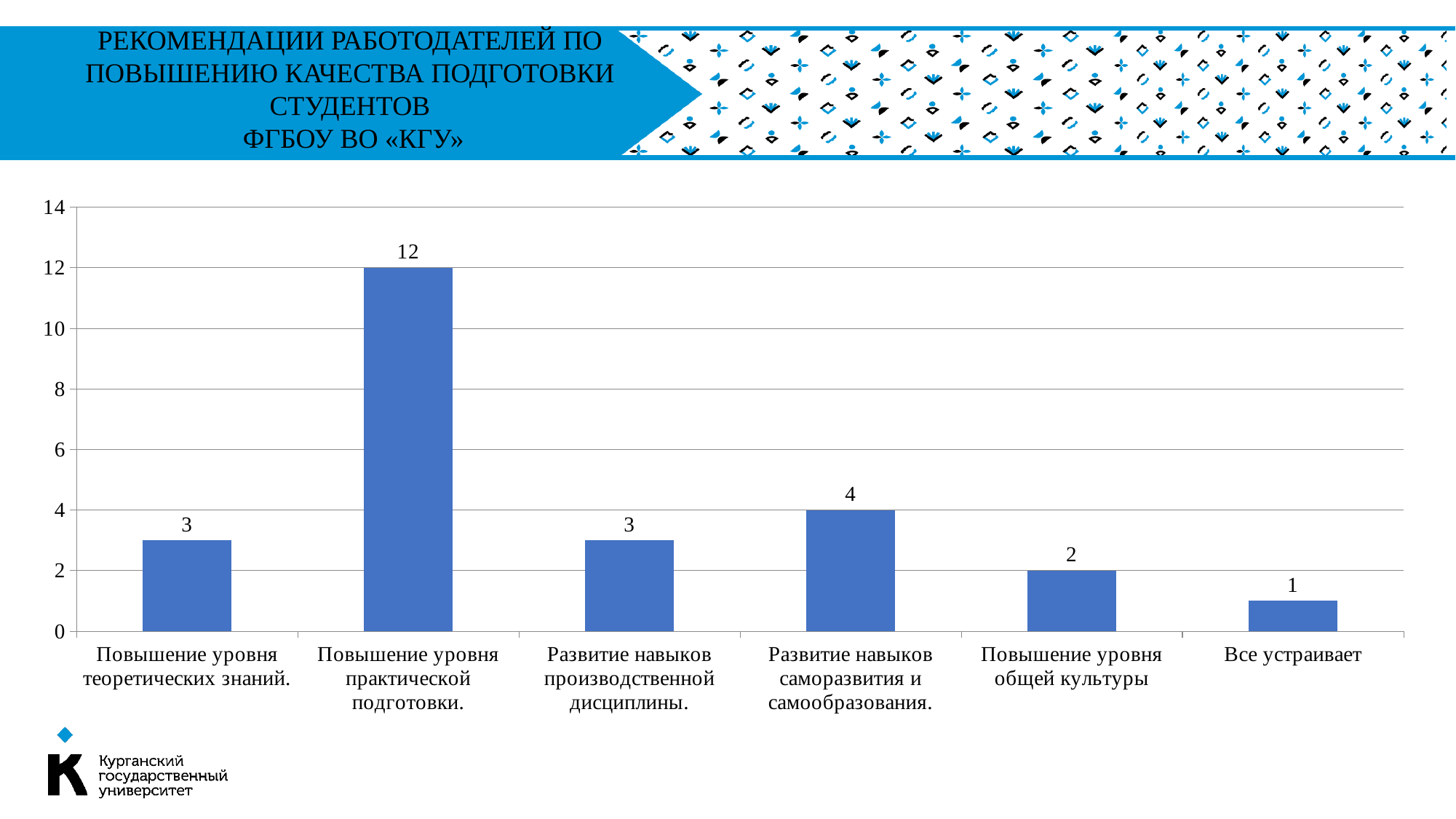
Which category has the highest value? Повышение уровня практической подготовки Which is larger: the value for «Развитие навыков производственной дисциплины» or the value for «Повышение уровня общей культуры»? Развитие навыков производственной дисциплины What is the value for «Все устраивает»? 1 What is the value for «Повышение уровня практической подготовки»? 12 What is the value for «Развитие навыков саморазвития и самообразования»? 4 What is the difference between the values for «Повышение уровня практической подготовки» and «Развитие навыков саморазвития и самообразования»? 8 What is the maximum value shown on the vertical axis? 14 How many categories are shown on the x axis? 6 Is the value for «Повышение уровня практической подготовки» greater or less than 10? greater What kind of chart is shown on the slide? bar chart Which category has the lowest value? Все устраивает What is the value for «Повышение уровня общей культуры»? 2